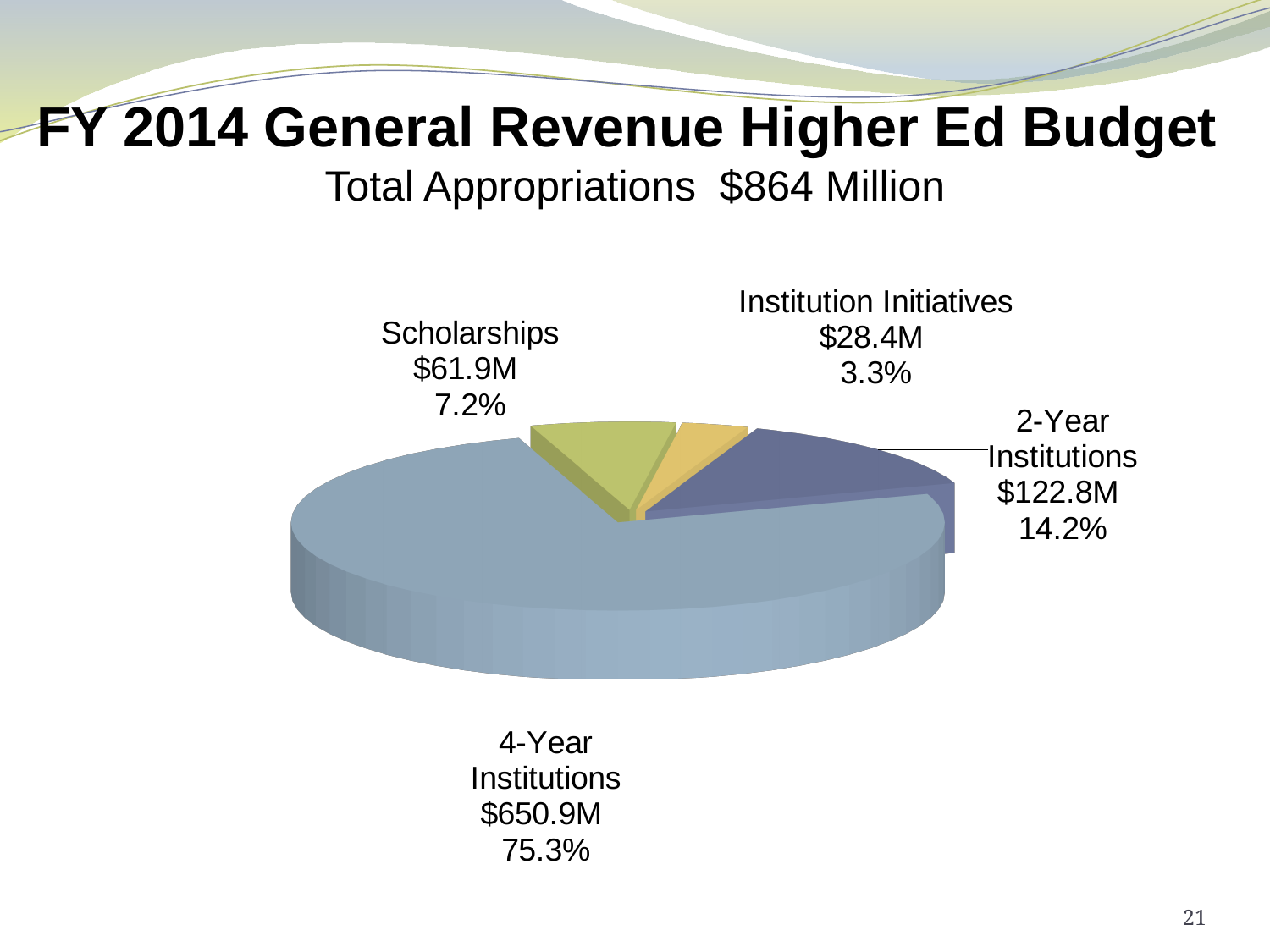
How many slices does the pie chart have? 4 What is the difference in dollars between 2-Year Institutions and Scholarships? $60.9M What share of the pie do 4-Year Institutions represent? 75.3% Which is larger, Scholarships or 2-Year Institutions? 2-Year Institutions What total appropriations amount is stated in the chart's subtitle? $864 Million What is the dollar amount for Institution Initiatives? $28.4M Which category has the smallest slice? Institution Initiatives What share of the pie do 2-Year Institutions represent? 14.2% What kind of chart is shown on the slide? pie chart What is the dollar amount for 4-Year Institutions? $650.9M What is the dollar amount for Scholarships? $61.9M Which category has the largest slice? 4-Year Institutions